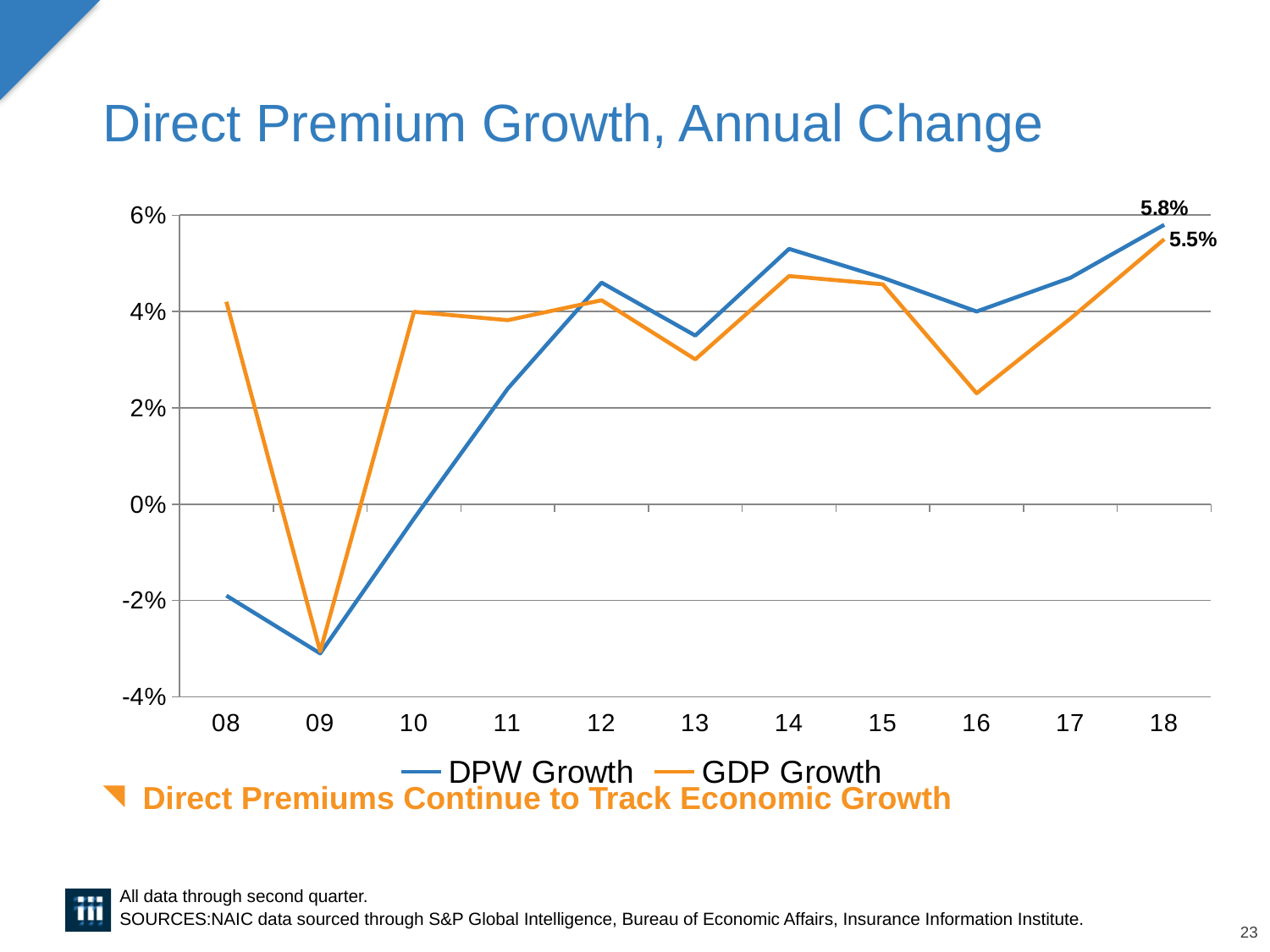
What is the difference between DPW Growth and GDP Growth in 18? 0.3% How many years are plotted along the x axis? 11 What is the DPW Growth value for 18? 5.8% What is the GDP Growth value for 18? 5.5% In 18, which series has the higher value, DPW Growth or GDP Growth? DPW Growth Is the GDP Growth value for 16 greater or less than 4%? less In which year is DPW Growth at its lowest? 09 Is the GDP Growth value for 08 greater or less than 2%? greater Do the DPW Growth values rise or fall from 09 to 12? rise How many series does the legend list? 2 Is the DPW Growth value for 09 greater or less than -2%? less What kind of chart is shown on the slide? line chart